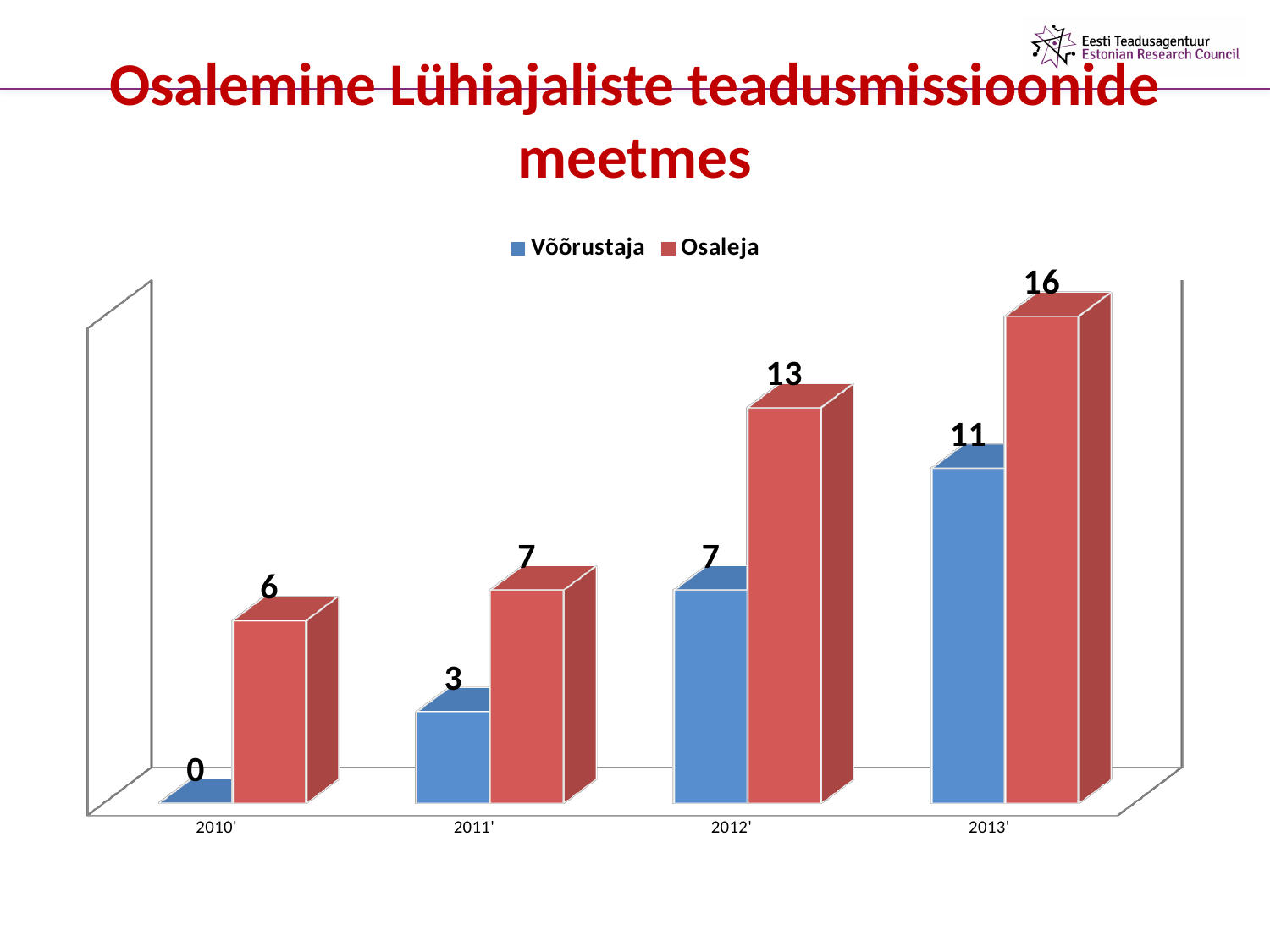
Which is larger in 2011': Võõrustaja or Osaleja? Osaleja What is the value for Osaleja in 2013'? 16 What is the value for Võõrustaja in 2010'? 0 What kind of chart is shown on the slide? bar chart Which year has the lowest Võõrustaja value? 2010' What is the difference between the Osaleja and Võõrustaja values in 2012'? 6 How many series does the legend list? 2 What is the value for Võõrustaja in 2012'? 7 Do the Osaleja values rise or fall from 2010' to 2013'? rise Which colour represents the Osaleja series? red Which year has the highest Osaleja value? 2013' How many years are shown on the x axis? 4